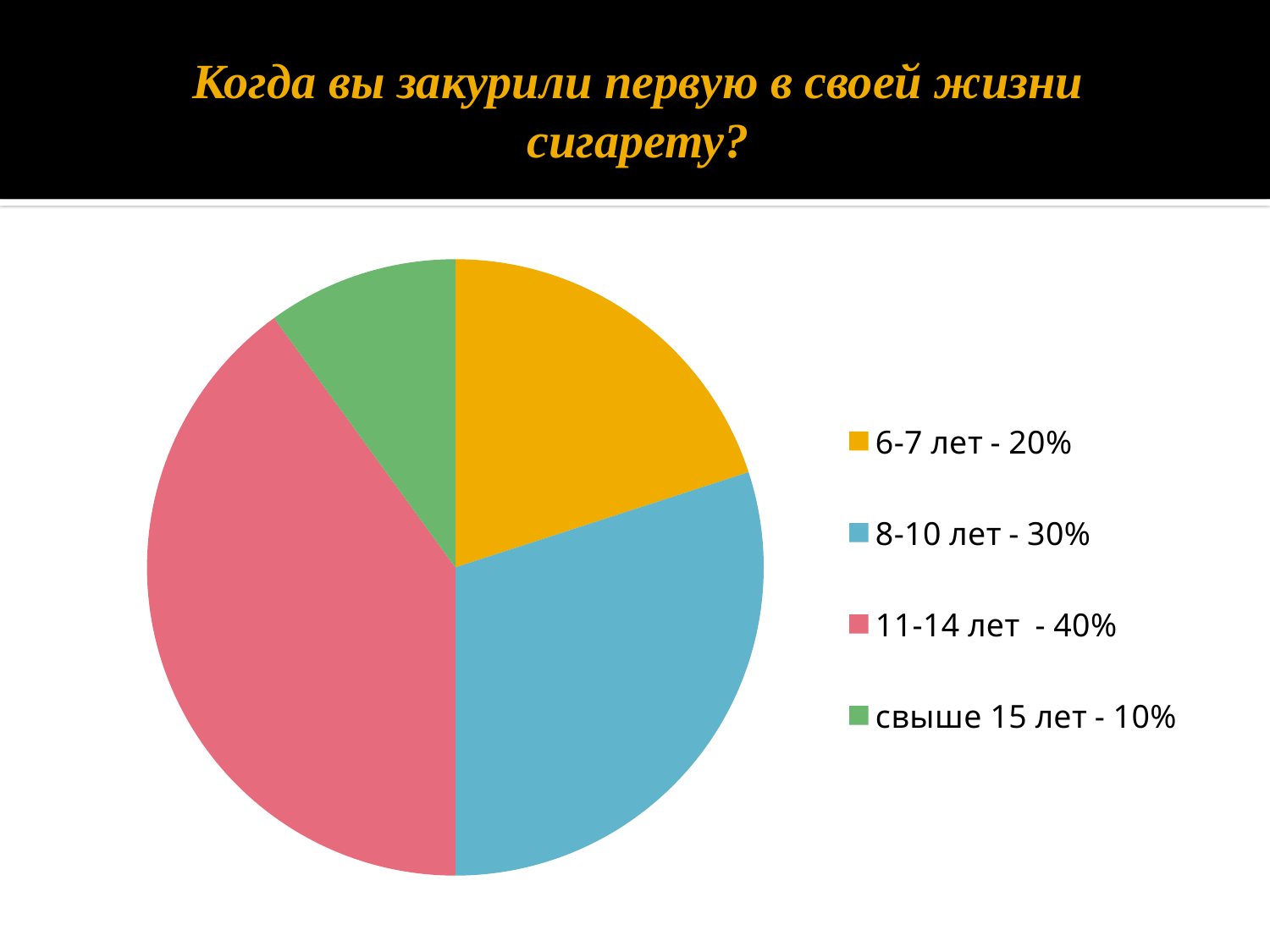
What kind of chart is shown on the slide? pie chart What is the title of the slide containing the pie chart? Когда вы закурили первую в своей жизни сигарету? What colour is the slice for "11-14 лет"? red (pink) What is the difference between the shares for "11-14 лет" and "6-7 лет"? 20% How many slices does the pie chart have? 4 What share of the pie does the "свыше 15 лет" slice represent? 10% Which category has the smallest slice of the pie? свыше 15 лет What is the value shown in the legend for "8-10 лет"? 30% What share of the pie does the "6-7 лет" slice represent? 20% Which category has the largest slice of the pie? 11-14 лет Which is larger, the share for "8-10 лет" or the share for "6-7 лет"? 8-10 лет What share of the pie does the "11-14 лет" slice represent? 40%